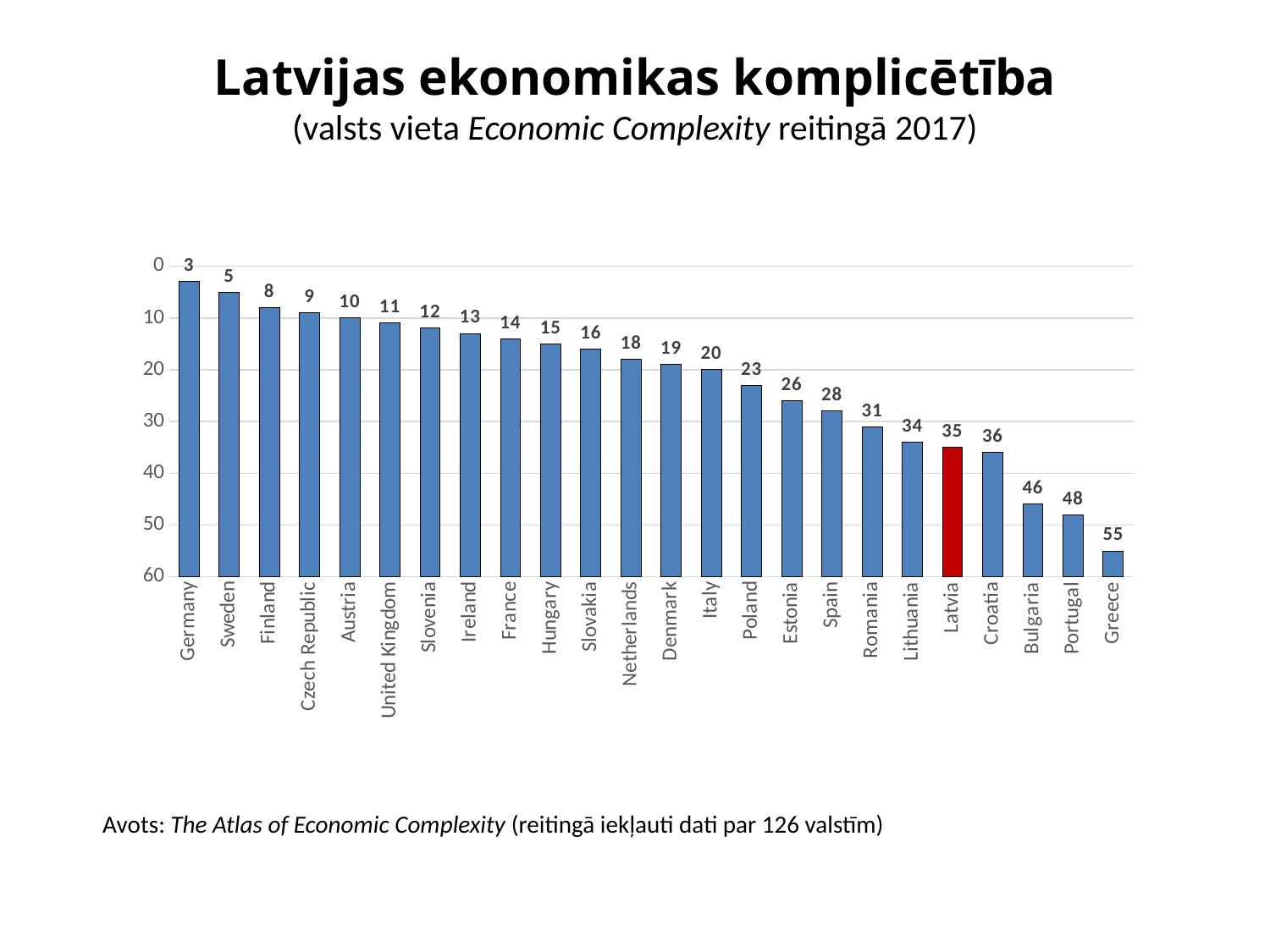
What is the value shown for Greece? 55 Which country's bar is coloured red? Latvia Which country has the largest value on the chart? Greece What kind of chart is shown on the slide? Bar chart What is the difference between the values for Latvia and Lithuania? 1 Which country has the smallest value on the chart? Germany What is the difference between the values for Greece and Germany? 52 What is the value shown for Estonia? 26 What is the value shown for Latvia? 35 How many countries are shown on the chart? 24 Which has the larger value, Poland or Spain? Spain What is the value shown for Germany? 3